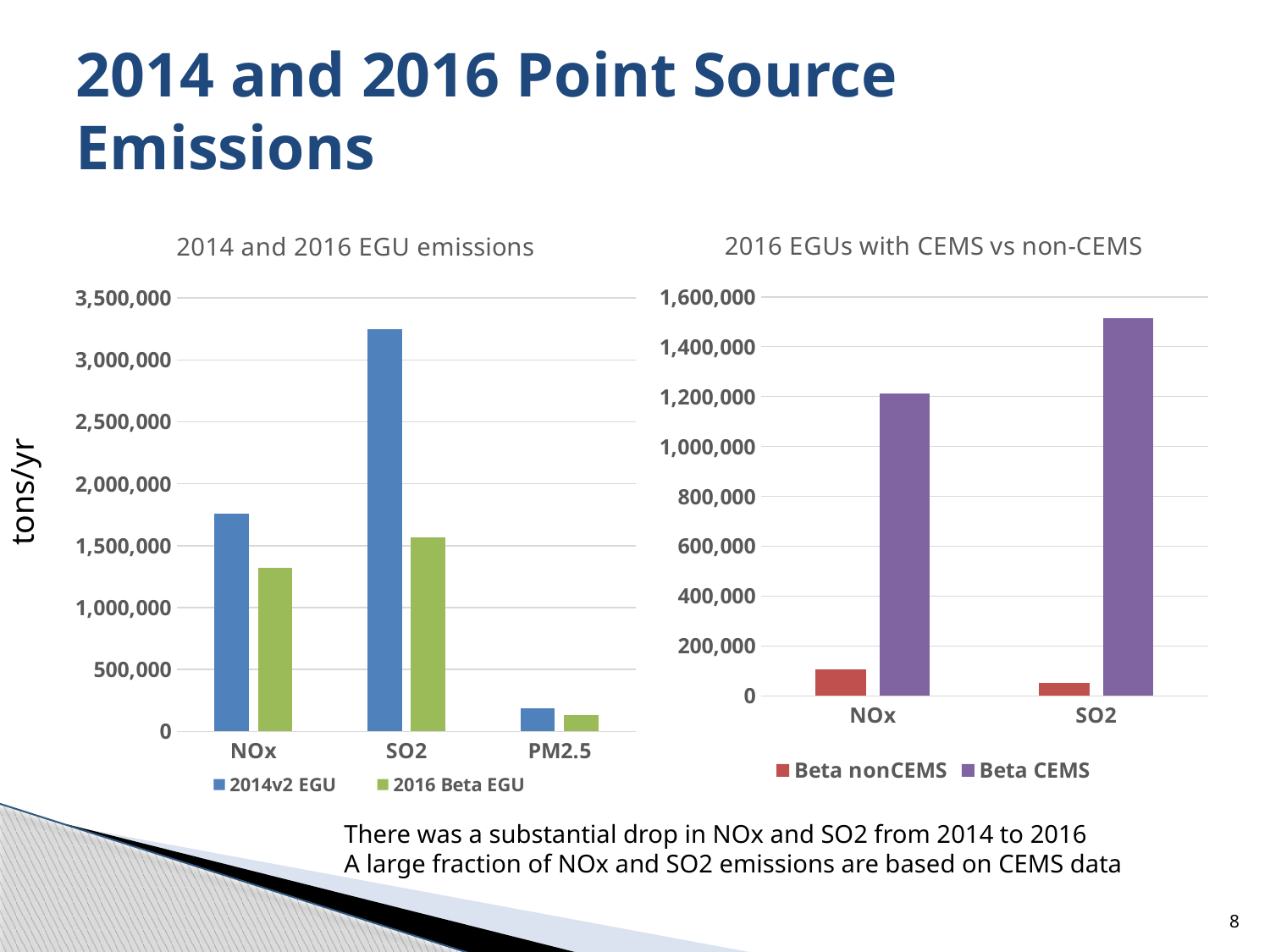
In the '2014 and 2016 EGU emissions' chart, which is larger for SO2: the 2014v2 EGU value or the 2016 Beta EGU value? 2014v2 EGU In the '2016 EGUs with CEMS vs non-CEMS' chart, is the Beta CEMS value for SO2 greater or less than 1,400,000? greater How many series does the legend of the '2014 and 2016 EGU emissions' chart list? 2 In the '2014 and 2016 EGU emissions' chart, is the 2014v2 EGU value for SO2 greater or less than 3,000,000? greater In the '2016 EGUs with CEMS vs non-CEMS' chart, which category has the higher Beta CEMS value? SO2 What is the y-axis label of the '2014 and 2016 EGU emissions' chart? tons/yr In the '2016 EGUs with CEMS vs non-CEMS' chart, is the Beta nonCEMS value for NOx greater or less than 200,000? less In the '2014 and 2016 EGU emissions' chart, which category has the lowest 2016 Beta EGU value? PM2.5 In the '2014 and 2016 EGU emissions' chart, which category has the highest 2014v2 EGU value? SO2 What kind of chart is the '2016 EGUs with CEMS vs non-CEMS' chart? Bar chart How many categories are shown on the x axis of the '2014 and 2016 EGU emissions' chart? 3